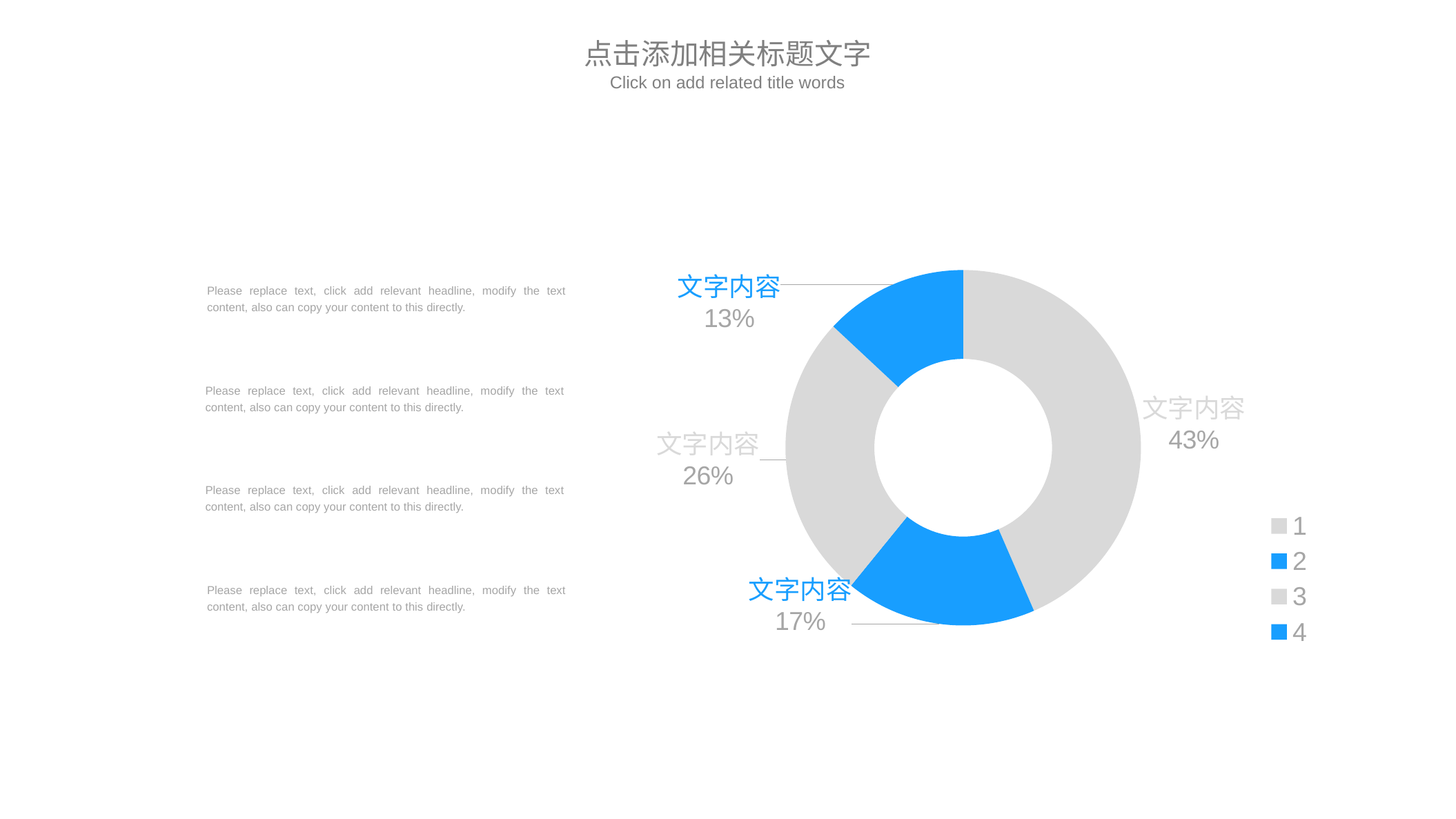
What is the difference in percentage points between the largest slice (43%) and the smallest slice (13%)? 30 What percentage is shown for legend category 4 (the blue slice at the top left)? 13% Which legend category has the largest slice in the doughnut chart? 1 What percentage is shown for legend category 2 (the blue slice at the bottom)? 17% Which legend category has the smallest slice in the doughnut chart? 4 What percentage is shown for legend category 1 (the large grey slice on the right)? 43% Which is larger, the slice for legend category 2 or the slice for legend category 3? 3 What is the combined share of the two blue slices (categories 2 and 4)? 30% How many entries does the legend of the doughnut chart list? 4 How many slices does the doughnut chart have? 4 What kind of chart is shown on the slide? doughnut chart What percentage is shown for legend category 3 (the grey slice on the left)? 26%